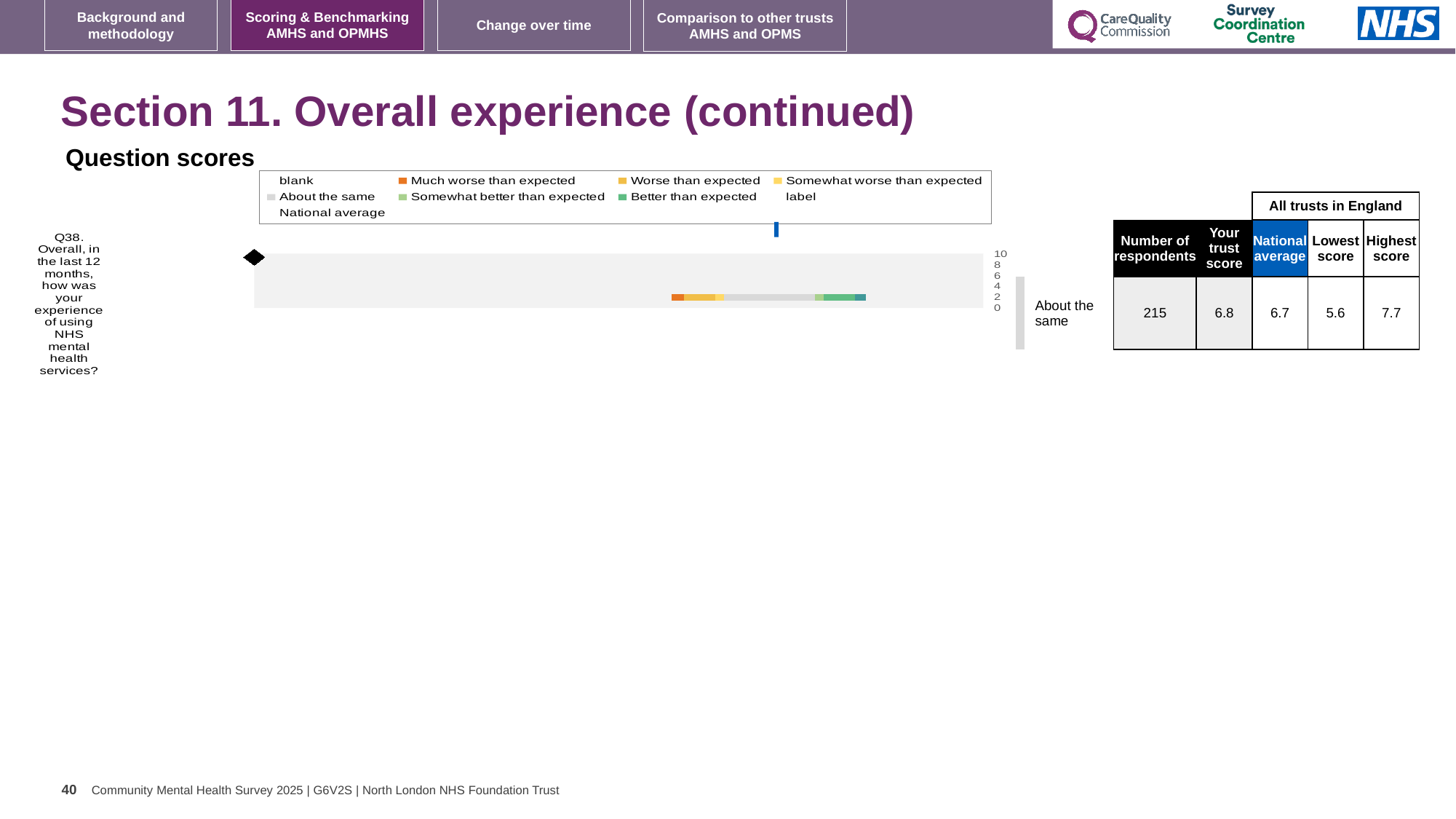
In the Question scores chart legend, what colour represents 'Much worse than expected'? orange How many respondents answered Q38 according to the table beside the chart? 215 What is the lowest score among all trusts in England for Q38? 5.6 For Q38, what is the difference between the highest score and the lowest score among all trusts in England? 2.1 How many survey questions are plotted in the Question scores chart? 1 For Q38, which is larger: the trust score or the national average? the trust score What is the highest score among all trusts in England for Q38? 7.7 What is the national average score for Q38 in the table beside the chart? 6.7 What is 'Your trust score' for Q38 in the table beside the chart? 6.8 Which benchmark category is shown next to the Q38 bar in the Question scores chart? About the same What kind of chart is used to show the Q38 question score? bar chart For Q38, what is the difference between the trust score and the national average? 0.1